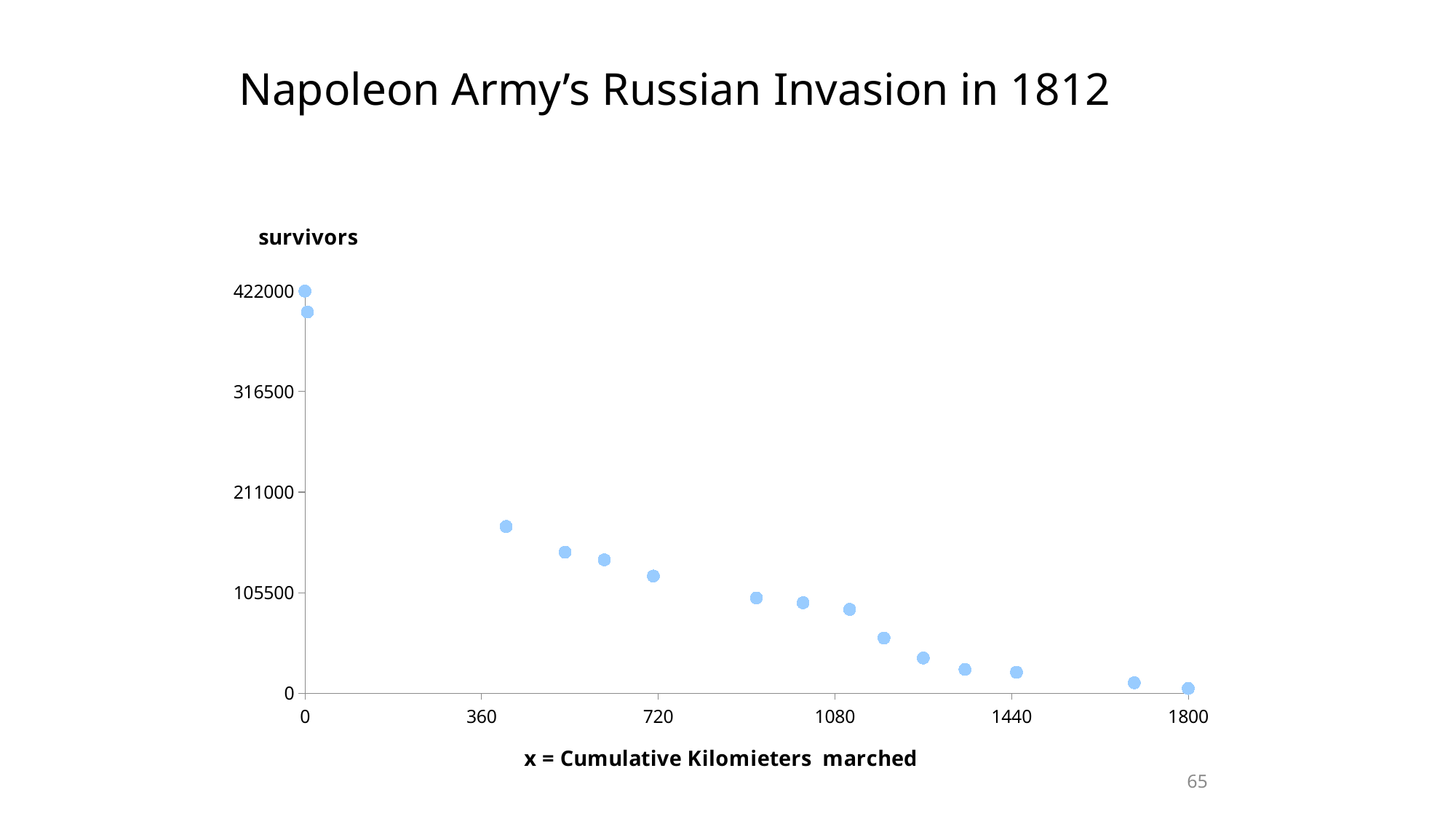
What is the label of the x axis? x = Cumulative Kilomieters marched What is the title of the slide's chart? Napoleon Army's Russian Invasion in 1812 Is the survivors value at about 1440 cumulative kilometers greater or less than 105500? less At which x value (cumulative kilometers marched) is the highest survivors value plotted? 0 What kind of chart is shown on the slide? scatter chart Is the survivors value at 1800 cumulative kilometers greater or less than 105500? less Do the survivor values rise or fall as cumulative kilometers marched increases? fall Is the survivors value at about 360 cumulative kilometers greater or less than 105500? greater How many data points are plotted on the chart? 15 What is the highest survivors value plotted on the chart? 422000 Which has more survivors: the point at about 360 kilometers or the point at about 1080 kilometers? the point at about 360 kilometers